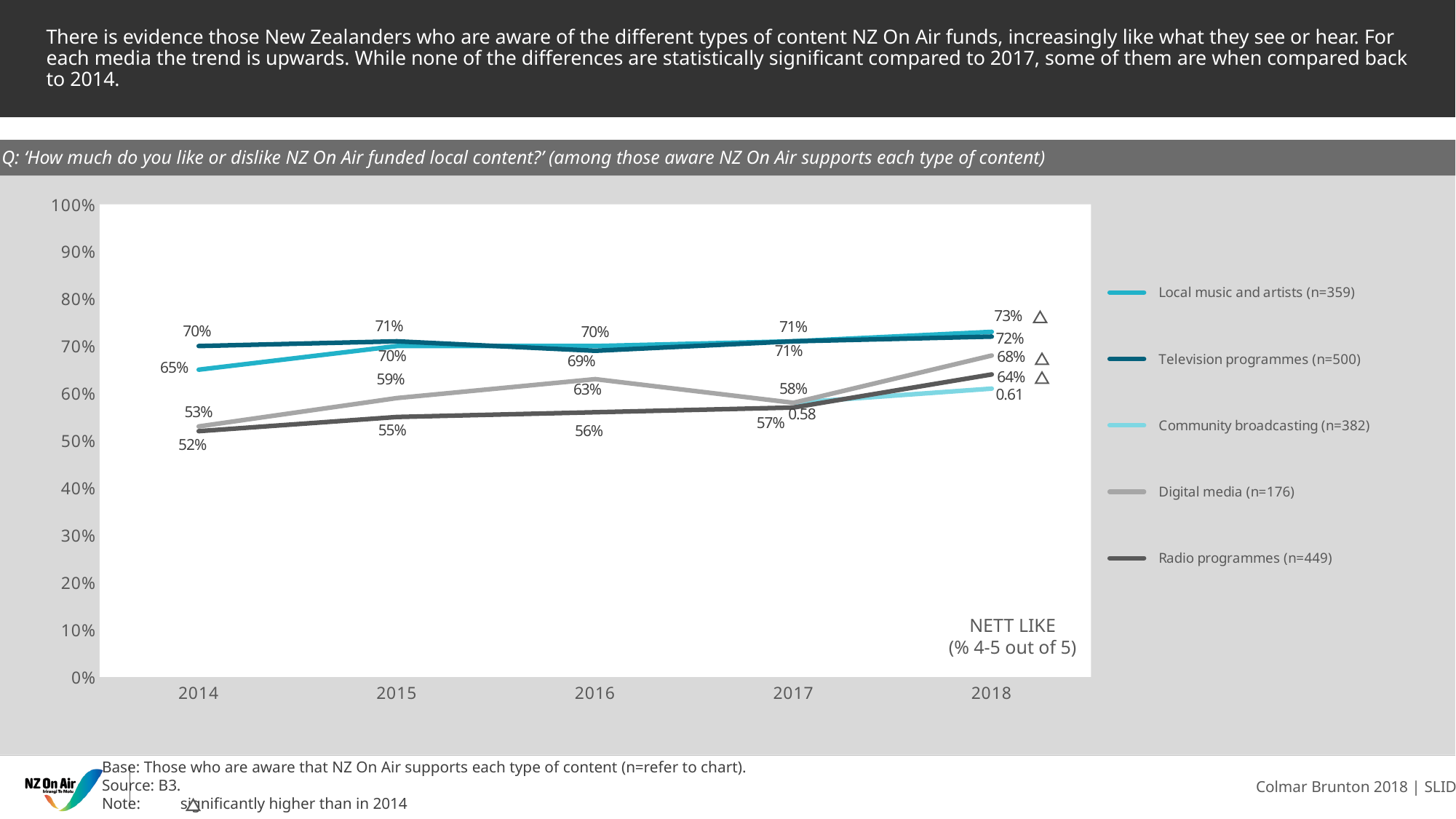
How many series does the legend list? 5 What is the value for Local music and artists in 2014? 65% Does the value for Radio programmes rise or fall from 2014 to 2018? Rise In 2018, which is larger: the value for Digital media or the value for Radio programmes? Digital media What is the difference between the Digital media values in 2018 and 2014? 15 percentage points What type of chart is shown on the slide? Line chart Which series has the lowest value in 2014? Radio programmes What is the value for Digital media in 2016? 63% What sample size (n) does the legend give for Television programmes? n=500 What is the value for Community broadcasting in 2018? 0.61 What is the value for Radio programmes in 2014? 52% How many years are shown on the x axis? 5